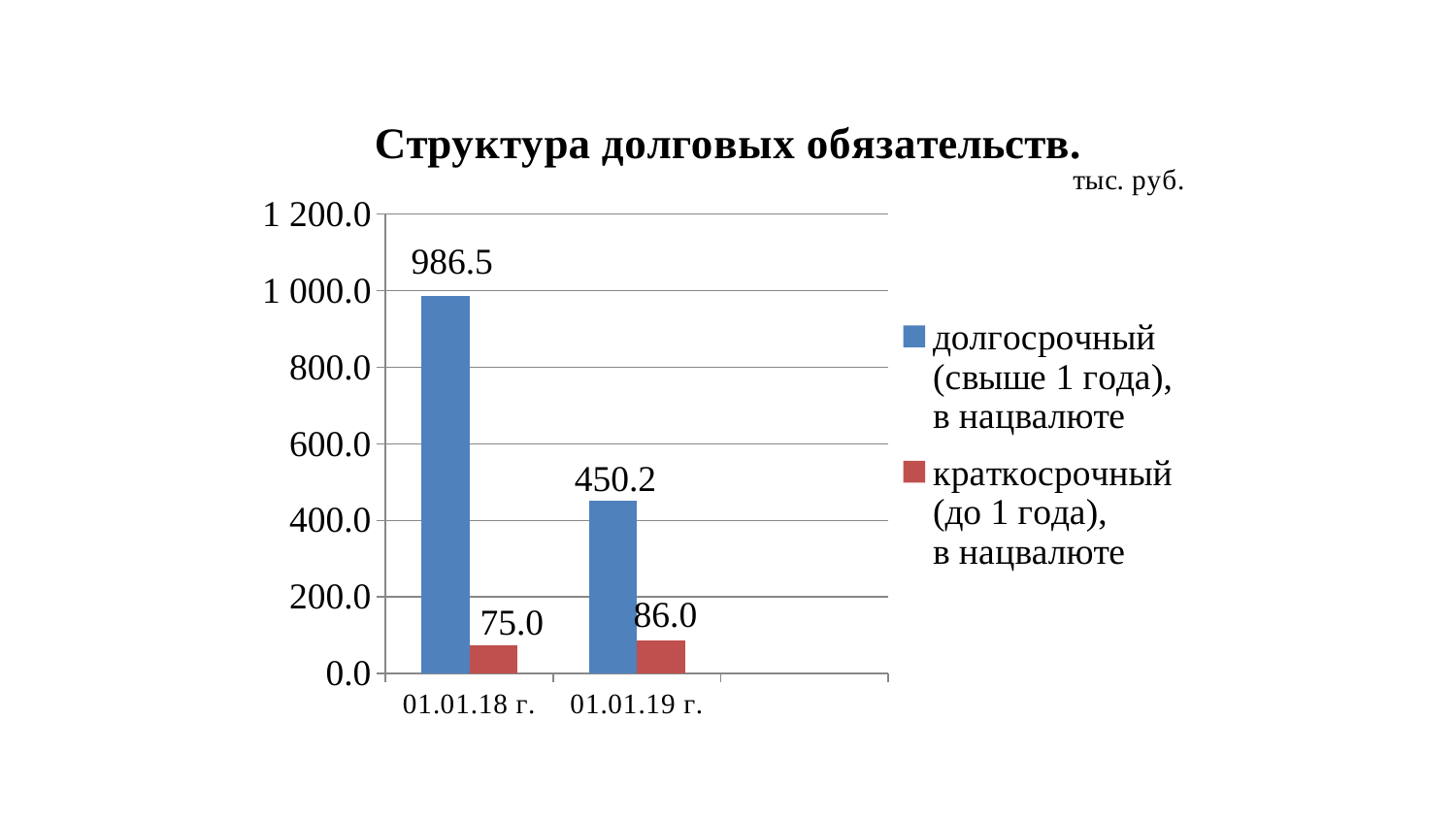
What is the title of the chart? Структура долговых обязательств. How many dates are shown on the x axis? 2 What is the value of краткосрочный (до 1 года), в нацвалюте for 01.01.18 г.? 75.0 What is the value of долгосрочный (свыше 1 года), в нацвалюте for 01.01.18 г.? 986.5 What is the value of краткосрочный (до 1 года), в нацвалюте for 01.01.19 г.? 86.0 Which date has the lowest value for краткосрочный (до 1 года), в нацвалюте? 01.01.18 г. What kind of chart is shown on the slide? Bar chart How many series does the legend list? 2 Which is larger: долгосрочный for 01.01.19 г. or краткосрочный for 01.01.19 г.? долгосрочный for 01.01.19 г. Which date has the highest value for долгосрочный (свыше 1 года), в нацвалюте? 01.01.18 г. What is the difference between the долгосрочный values for 01.01.18 г. and 01.01.19 г.? 536.3 What is the value of долгосрочный (свыше 1 года), в нацвалюте for 01.01.19 г.? 450.2